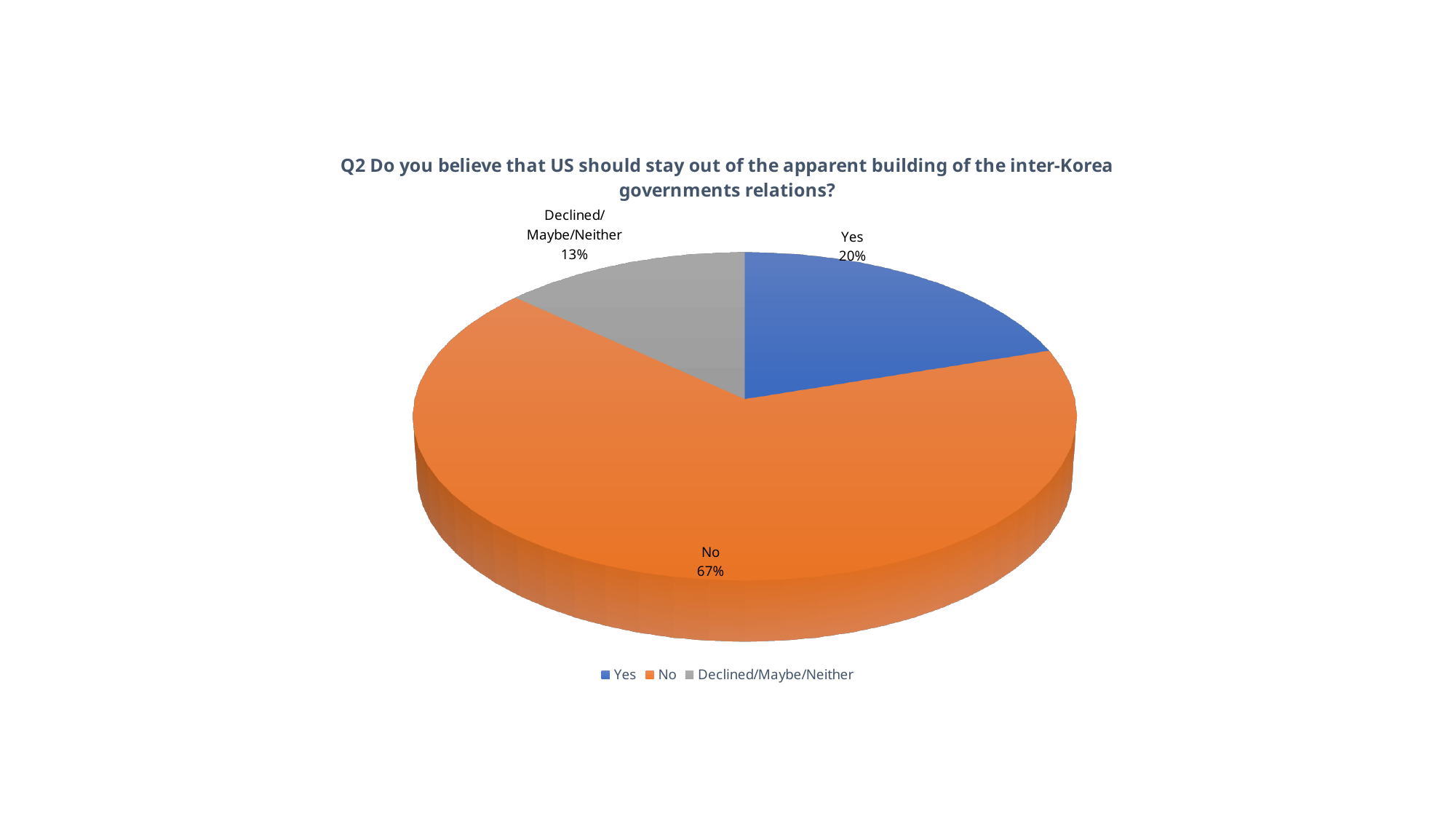
What share of the pie does the "Yes" slice represent? 20% What share of the pie does the "No" slice represent? 67% What kind of chart is shown on the slide? Pie chart What is the difference in percentage points between the "Yes" and "Declined/Maybe/Neither" slices? 7 What share of the pie does the "Declined/Maybe/Neither" slice represent? 13% What is the title of the chart? Q2 Do you believe that US should stay out of the apparent building of the inter-Korea governments relations? What is the difference in percentage points between the "No" and "Yes" slices? 47 How many categories are shown in the pie chart? 3 Which is larger, the "Yes" slice or the "Declined/Maybe/Neither" slice? Yes What colour is the "No" slice of the pie? Orange Which category has the largest slice of the pie? No Which category has the smallest slice of the pie? Declined/Maybe/Neither